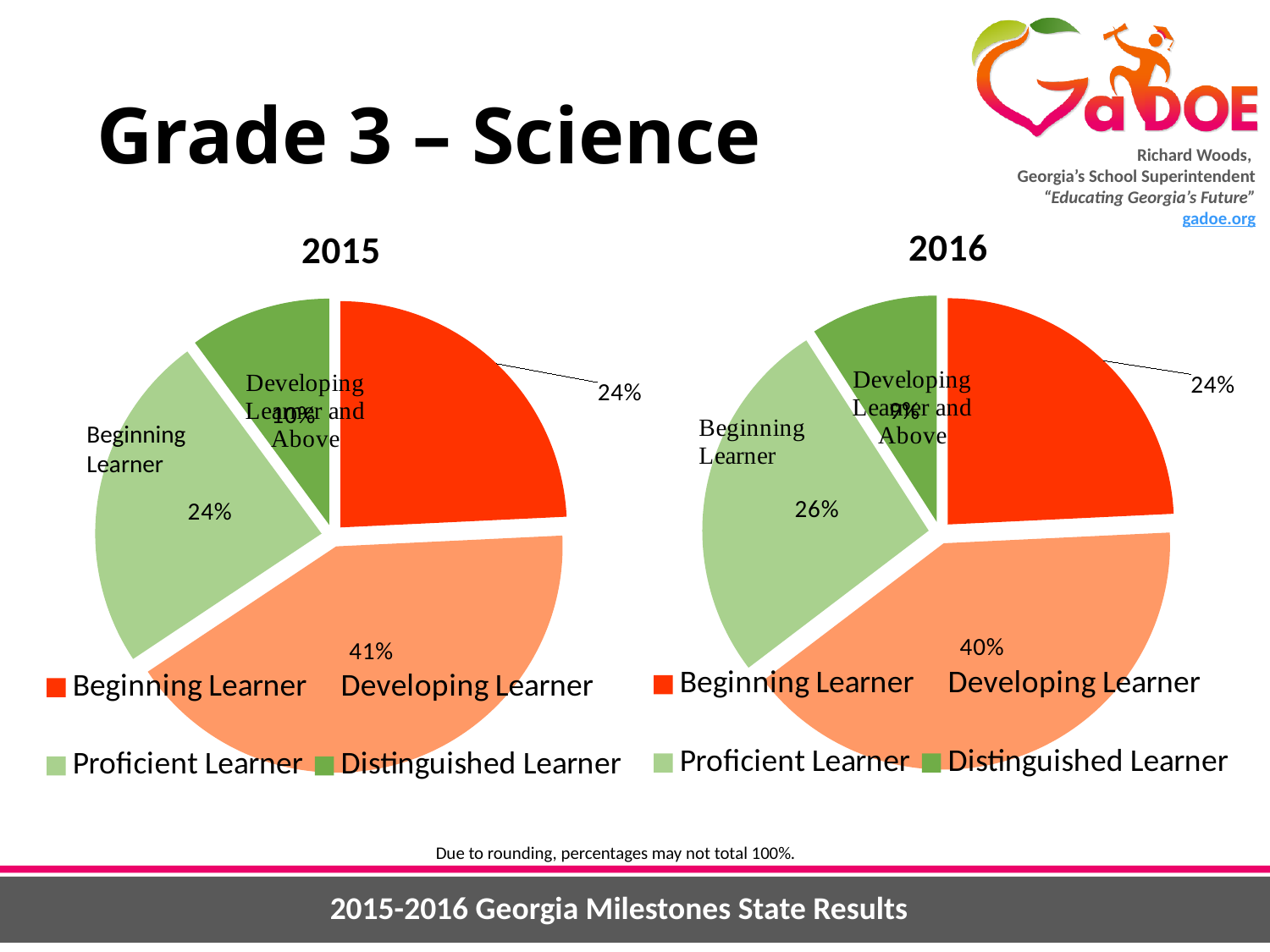
Is the Developing Learner share larger in the 2015 pie chart or the 2016 pie chart? 2015 How many categories does the legend of each pie chart list? 4 In the 2015 pie chart, what percentage is shown for Beginning Learner? 24% In the 2016 pie chart, which category has the smallest share? Distinguished Learner In the 2016 pie chart, what percentage is shown for Developing Learner? 40% What kind of charts are shown on the slide? Pie charts In the 2016 pie chart, what is the difference between the Developing Learner and Proficient Learner percentages? 14 percentage points In the legend, what colour represents Beginning Learner? Red In the 2015 pie chart, which category has the largest share? Developing Learner In the 2015 pie chart, what percentage is shown for Distinguished Learner? 10% In the 2016 pie chart, what percentage is shown for Proficient Learner? 26% In the 2015 pie chart, what percentage is shown for Developing Learner? 41%